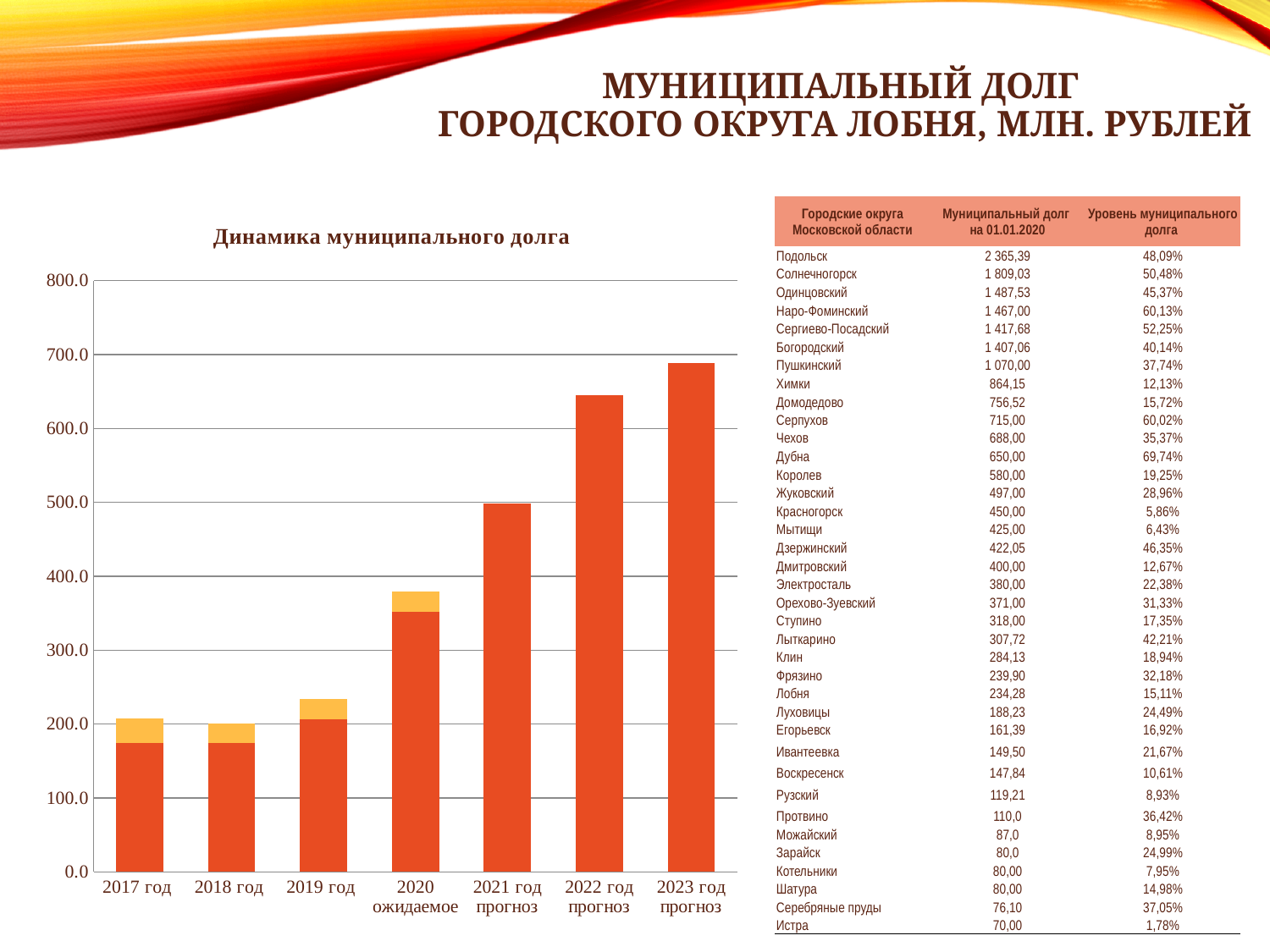
How many categories (years) are shown on the x axis of the chart? 7 Do the bar values generally rise or fall from 2019 год to 2023 год прогноз? rise What is the highest value shown on the y axis of the chart? 800.0 Which is larger, the bar for 2022 год прогноз or the bar for 2021 год прогноз? 2022 год прогноз Is the value for 2021 год прогноз greater or less than 400? greater What is the title of the chart on the slide? Динамика муниципального долга Is the value for 2022 год прогноз greater or less than 700? less Which category has the highest bar in the chart? 2023 год прогноз What kind of chart is shown on the slide? bar chart Is the total value for 2019 год greater or less than 300? less